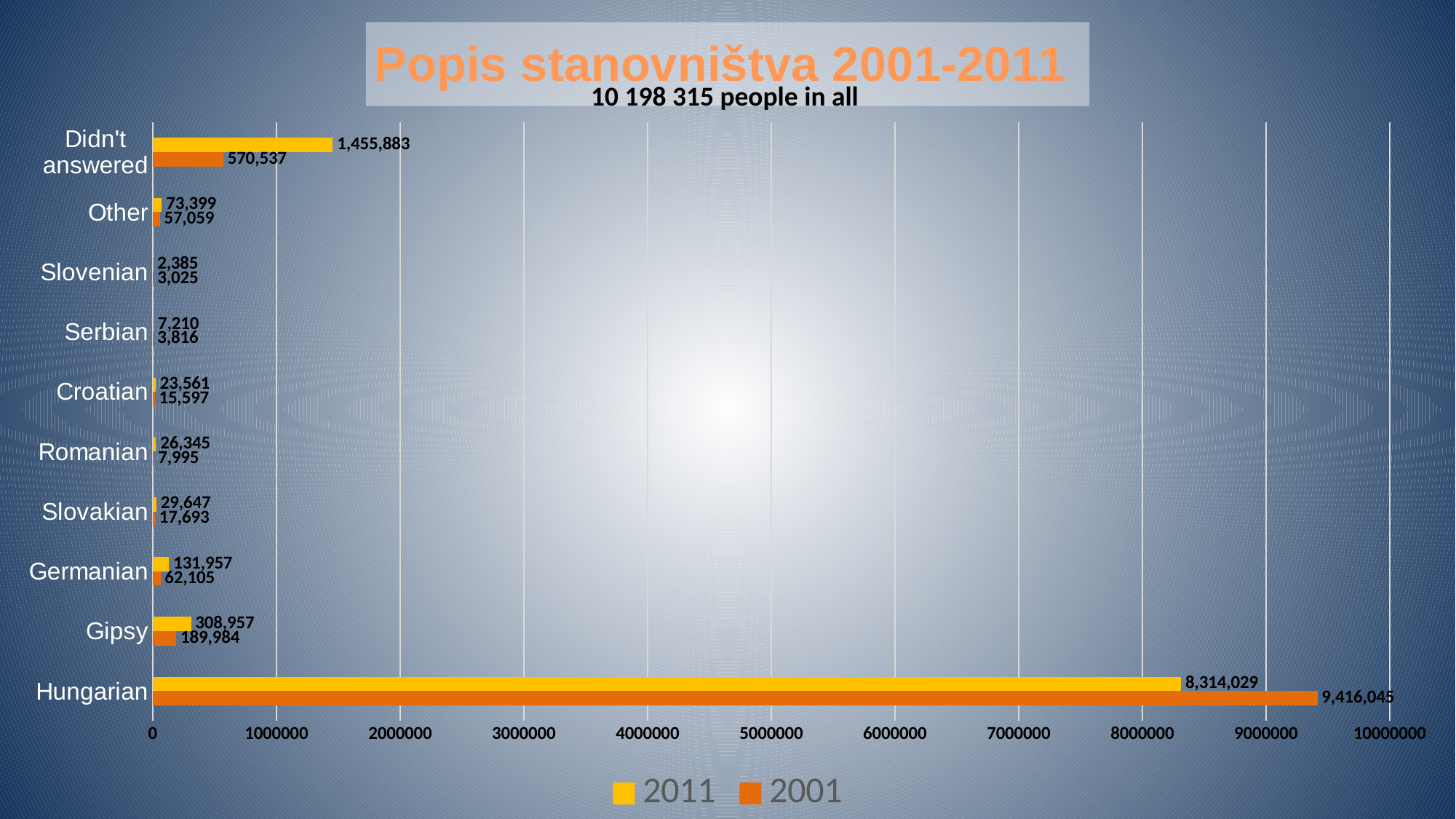
What is the 2011 value for Hungarian? 8,314,029 What is the 2011 value for Germanian? 131,957 Which category has the lowest 2011 value? Slovenian What is the 2001 value for Didn't answered? 570,537 What kind of chart is shown on the slide? Bar chart Which category has the highest 2001 value? Hungarian How many categories are shown on the chart? 10 What is the 2001 value for Gipsy? 189,984 What is the difference between the 2001 and 2011 values for Hungarian? 1,102,016 What is the difference between the 2011 and 2001 values for Gipsy? 118,973 How many series does the legend list? 2 Which is larger for Slovenian, the 2011 value or the 2001 value? 2001